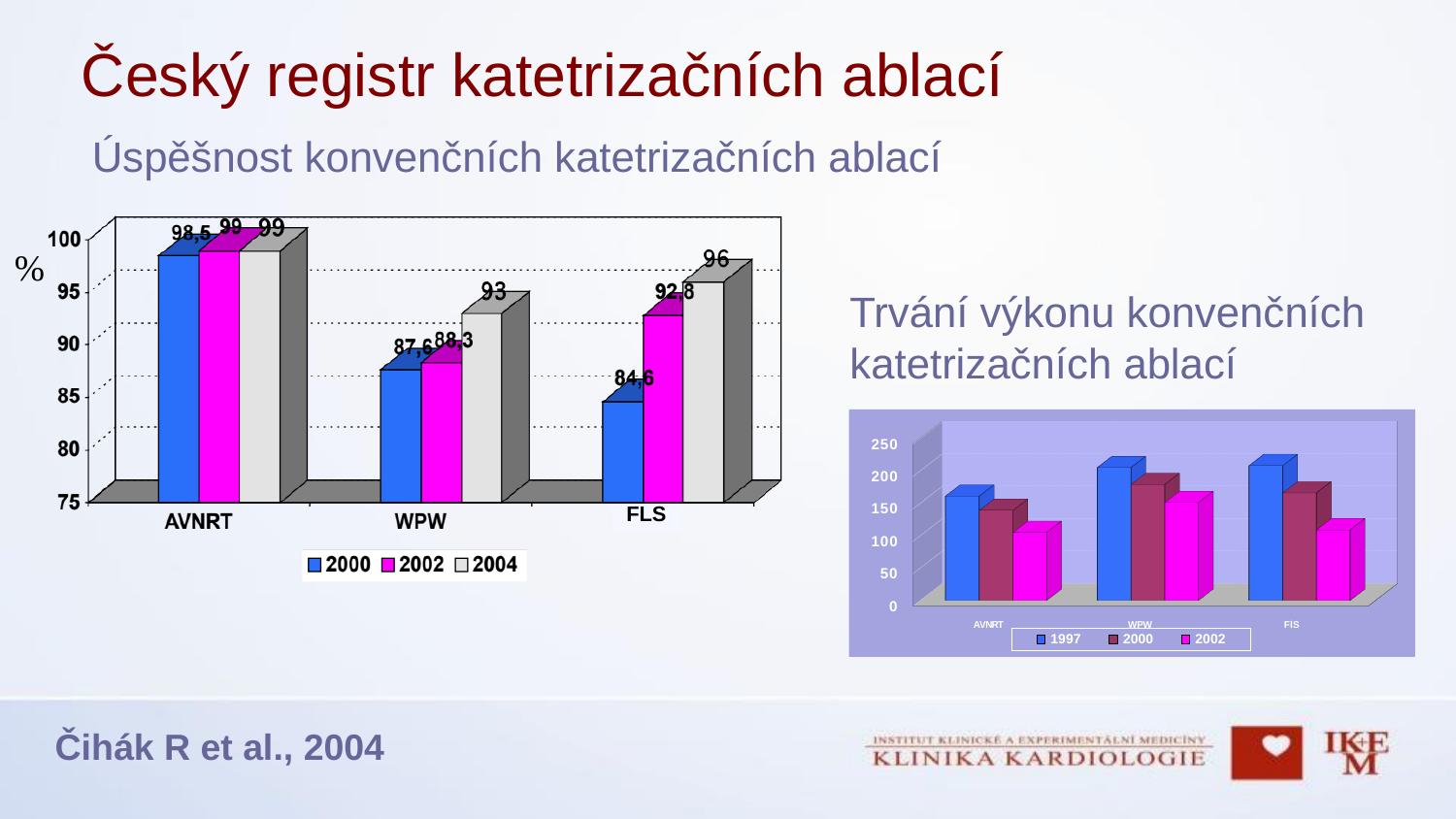
In the left chart (Úspěšnost konvenčních katetrizačních ablací), what is the value for WPW in 2004? 93 In the left chart (Úspěšnost konvenčních katetrizačních ablací), which category has the lowest value in 2000? FLS In the left chart (Úspěšnost konvenčních katetrizačních ablací), what is the difference between the FLS values for 2004 and 2000? 11,4 What kind of chart is the right chart (Trvání výkonu konvenčních katetrizačních ablací)? bar chart In the right chart (Trvání výkonu konvenčních katetrizačních ablací), is the value for AVNRT in 2002 greater or less than 150? less In the left chart (Úspěšnost konvenčních katetrizačních ablací), what is the value for AVNRT in 2000? 98,5 In the left chart (Úspěšnost konvenčních katetrizačních ablací), do the values for FLS rise or fall from 2000 to 2004? rise How many series does the legend of the left chart (Úspěšnost konvenčních katetrizačních ablací) list? 3 In the left chart (Úspěšnost konvenčních katetrizačních ablací), what is the value for FLS in 2000? 84,6 In the left chart (Úspěšnost konvenčních katetrizačních ablací), which is larger: WPW in 2002 or FLS in 2002? FLS in 2002 Which years does the legend of the right chart (Trvání výkonu konvenčních katetrizačních ablací) list? 1997, 2000, 2002